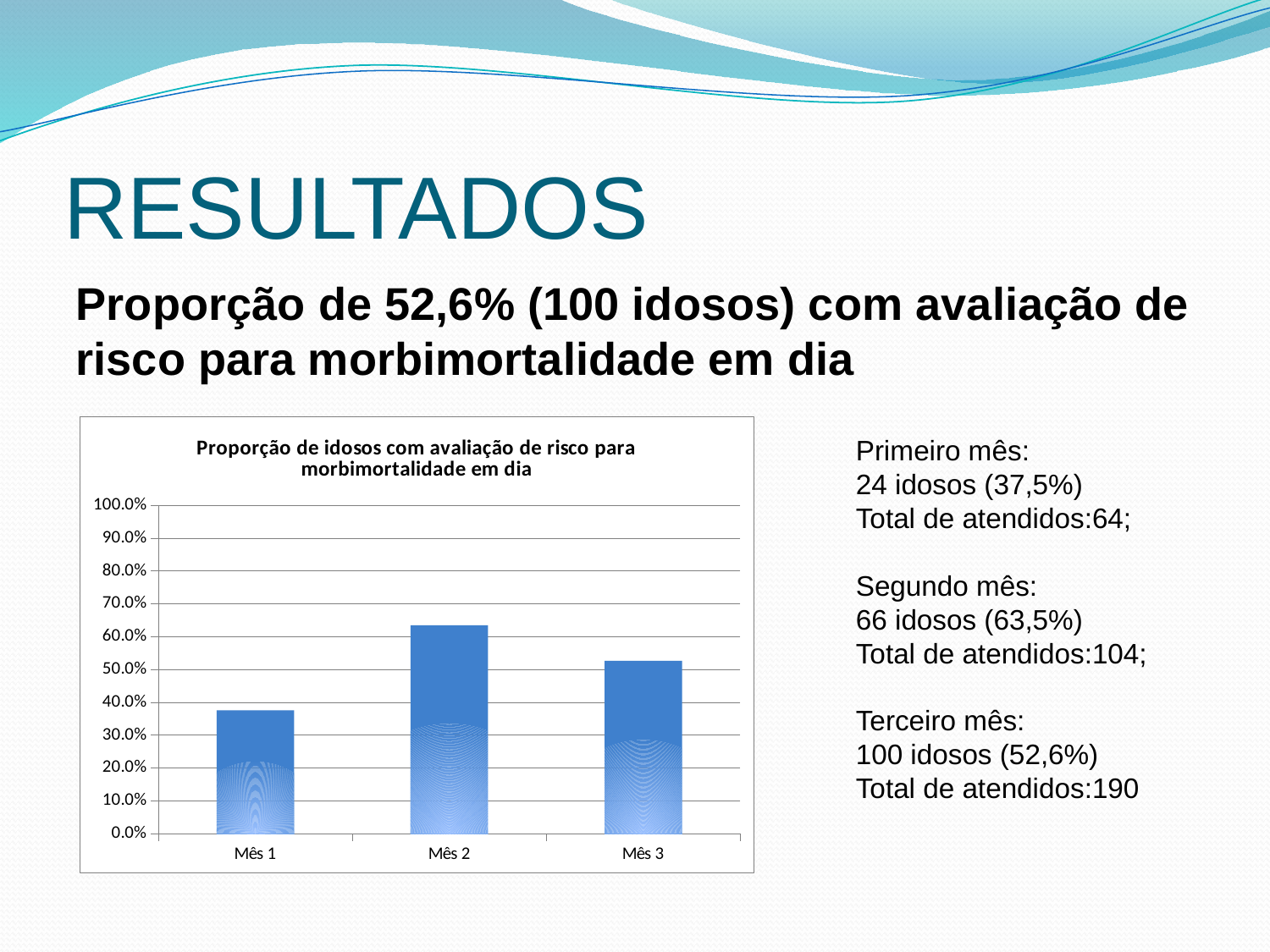
Is the value for Mês 1 greater or less than 40.0%? less Is the value for Mês 2 greater or less than 60.0%? greater What is the title of the chart? Proporção de idosos com avaliação de risco para morbimortalidade em dia How many categories are plotted on the x axis of the chart? 3 What kind of chart is shown on the slide? bar chart What is the highest value shown on the y axis of the chart? 100.0% Is the value for Mês 3 greater or less than 60.0%? less Which is larger, the value for Mês 2 or the value for Mês 3? Mês 2 Which month has the highest bar in the chart? Mês 2 Which month has the lowest bar in the chart? Mês 1